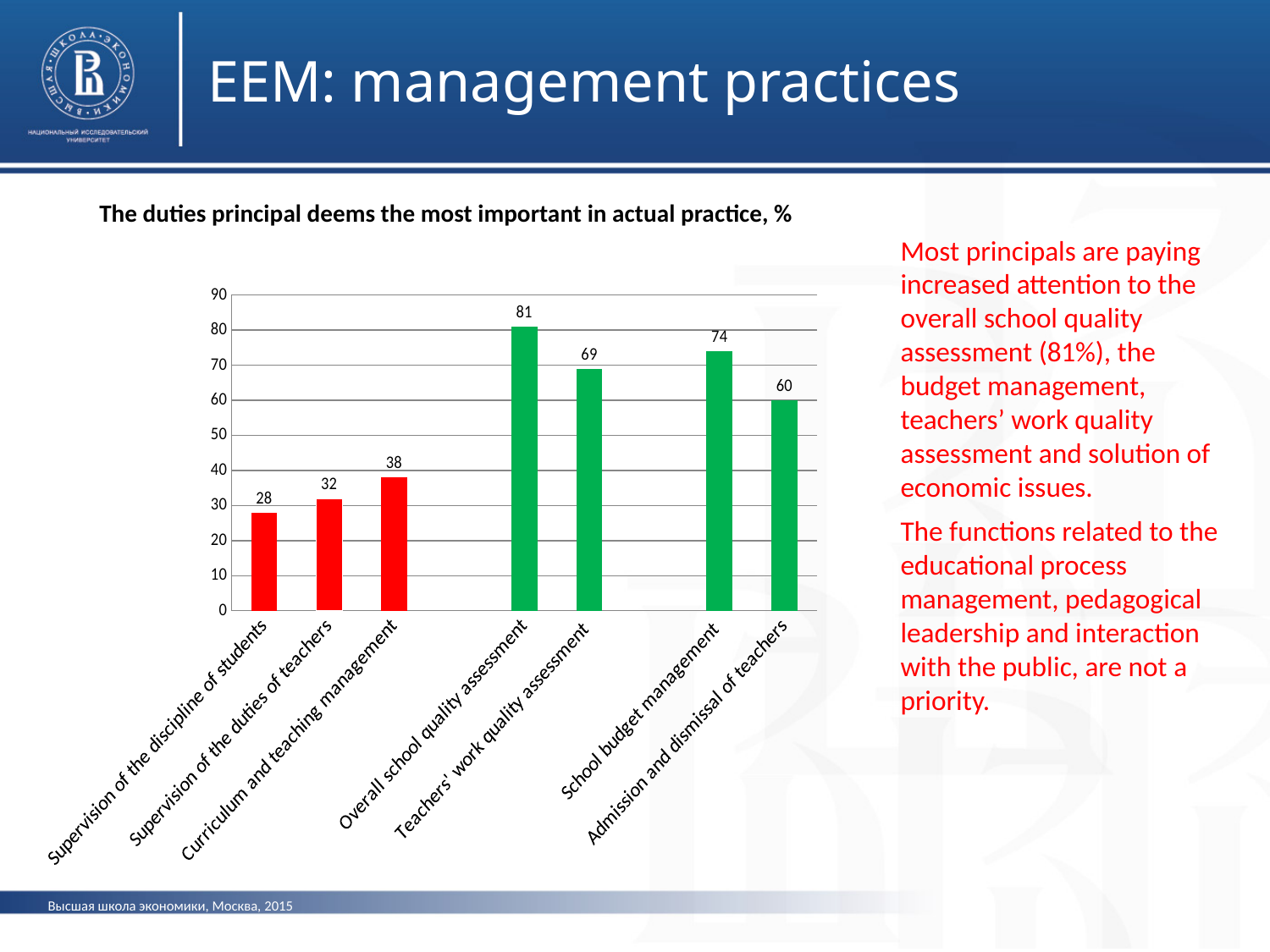
What is the value for School budget management? 74 What is the difference between the values for Supervision of the duties of teachers and Supervision of the discipline of students? 4 What is the difference between the values for Overall school quality assessment and Teachers' work quality assessment? 12 What colour are the bars for the three leftmost categories? Red What is the value for Supervision of the discipline of students? 28 How many categories are shown on the chart? 7 Is the value for Teachers' work quality assessment greater or less than 60? greater Which is larger, the value for Curriculum and teaching management or the value for Admission and dismissal of teachers? Admission and dismissal of teachers What kind of chart is shown on the slide? Bar chart What is the value for Overall school quality assessment? 81 Which category has the highest value? Overall school quality assessment Which category has the lowest value? Supervision of the discipline of students